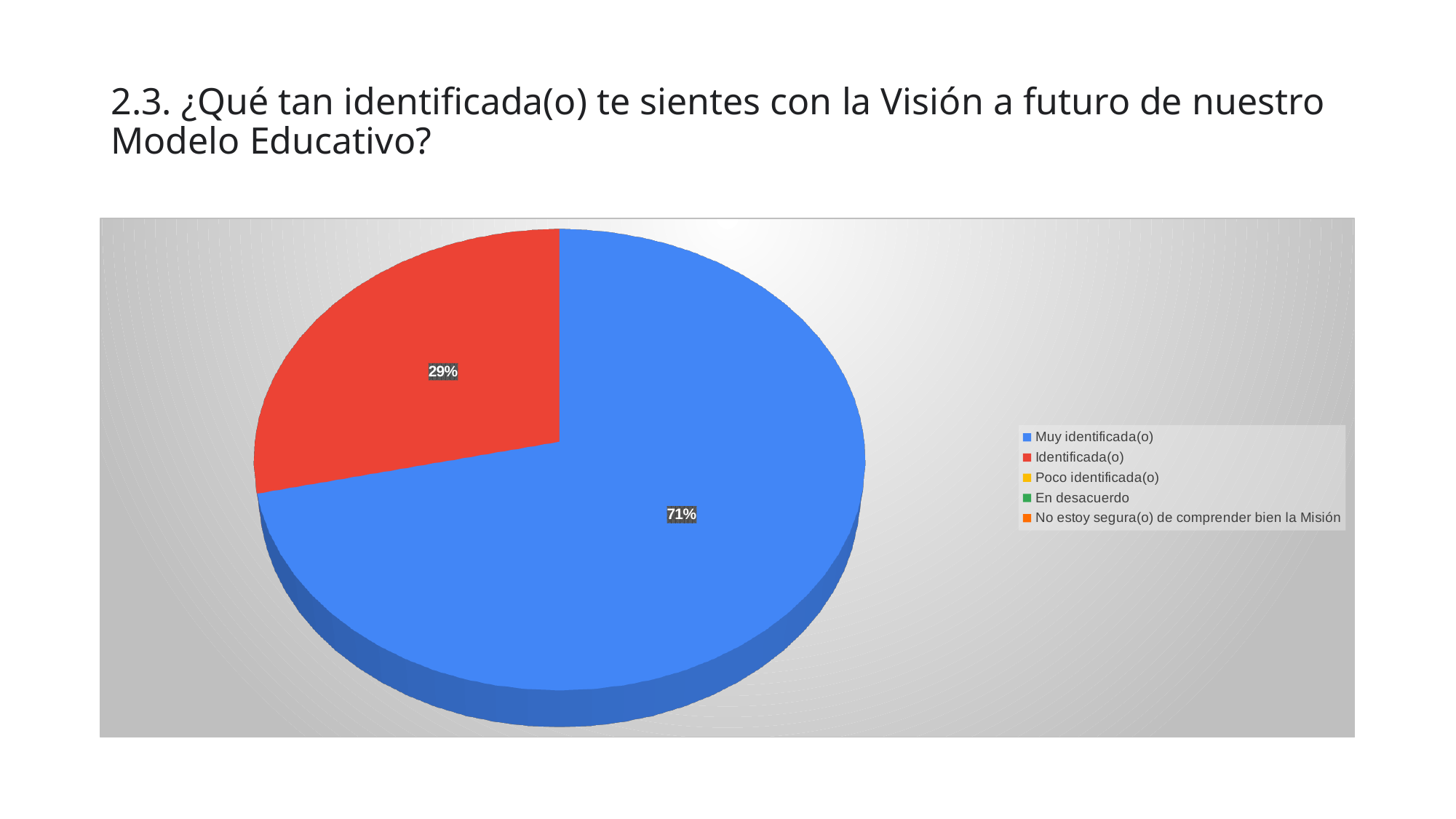
Which of the two visible slices is smaller, "Muy identificada(o)" or "Identificada(o)"? Identificada(o) Which category has the largest slice of the pie? Muy identificada(o) What kind of chart is shown on the slide? Pie chart Is the share for "Muy identificada(o)" greater or less than 50%? greater What is the difference in percentage points between the "Muy identificada(o)" and "Identificada(o)" slices? 42 What colour is the "Muy identificada(o)" slice? Blue What share of the pie does "Muy identificada(o)" represent? 71% How many slices are visible in the pie? 2 What share of the pie does "Identificada(o)" represent? 29% What colour is the "Identificada(o)" slice? Red How many categories does the legend list? 5